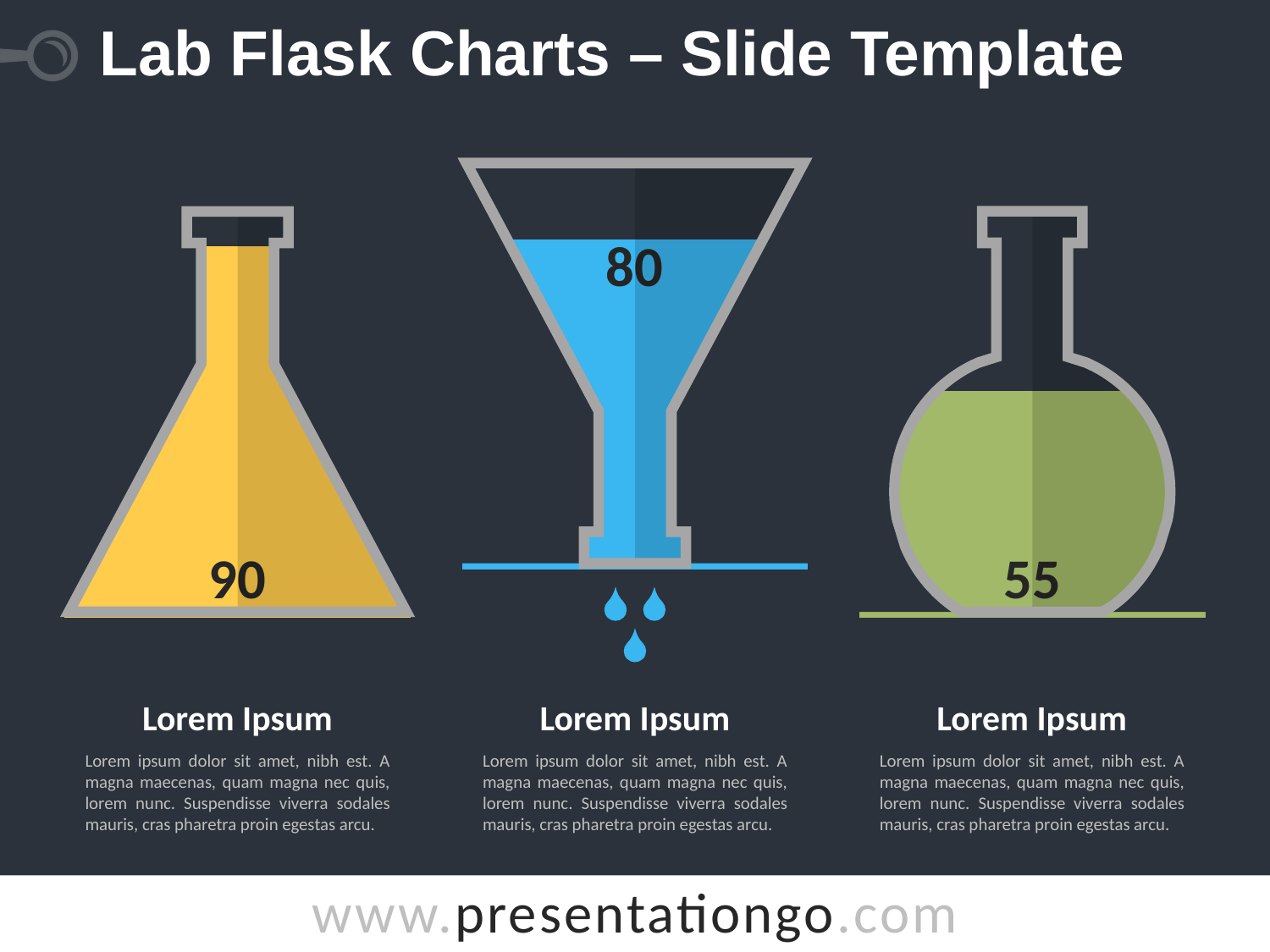
What colour is the liquid in the left conical flask? Yellow How many flask charts are shown on the slide? 3 What value is shown on the left flask (the conical flask)? 90 What is the total of the three values shown on the flask charts? 225 What value is shown on the right flask (the round-bottom flask)? 55 Which is larger, the value on the middle funnel or the value on the right flask? The middle funnel (80) What is the difference between the value on the left flask and the value on the right flask? 35 What colour is the liquid in the middle funnel? Blue Which of the three flask charts shows the highest value? The left conical flask (90) What is the difference between the value on the left flask and the value on the middle funnel? 10 Which of the three flask charts shows the lowest value? The right round-bottom flask (55) What value is shown on the middle funnel? 80